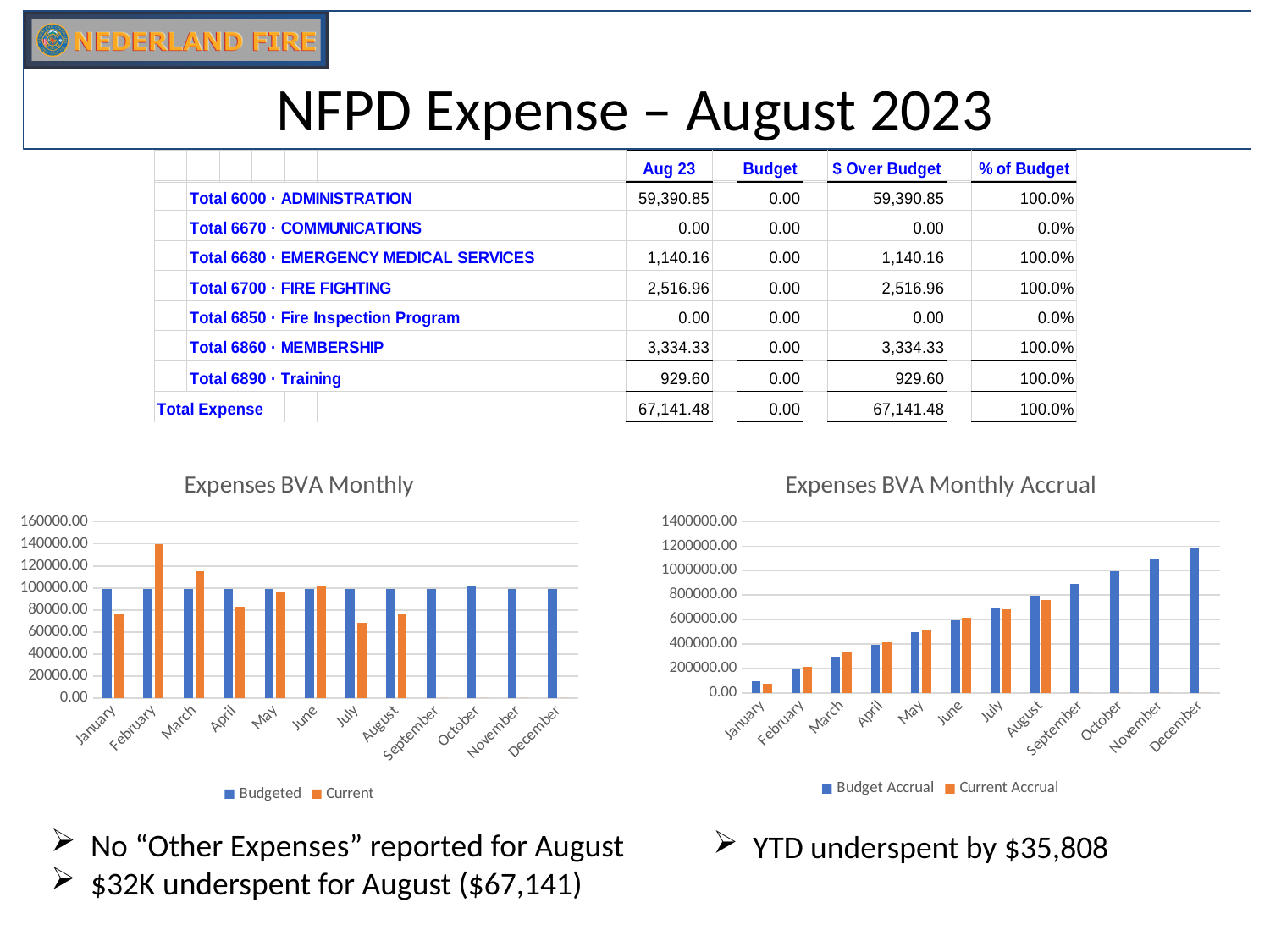
In the 'Expenses BVA Monthly Accrual' chart, is the Budget Accrual value for December greater or less than 1000000.00? greater In the 'Expenses BVA Monthly' chart, which month has the highest Current value? February What are the two legend entries on the 'Expenses BVA Monthly' chart? Budgeted and Current In the 'Expenses BVA Monthly' chart, is the Current value for July greater or less than 80000.00? less In the 'Expenses BVA Monthly Accrual' chart, is the Current Accrual value for January greater or less than 200000.00? less What kind of chart is the 'Expenses BVA Monthly' chart? bar chart In the 'Expenses BVA Monthly Accrual' chart, which month has the highest Budget Accrual value? December How many series does the legend of the 'Expenses BVA Monthly' chart list? 2 In the 'Expenses BVA Monthly' chart, which is larger for February, the Budgeted value or the Current value? Current In the 'Expenses BVA Monthly Accrual' chart, do the Budget Accrual values rise or fall from January to December? rise How many months are shown on the x axis of the 'Expenses BVA Monthly' chart? 12